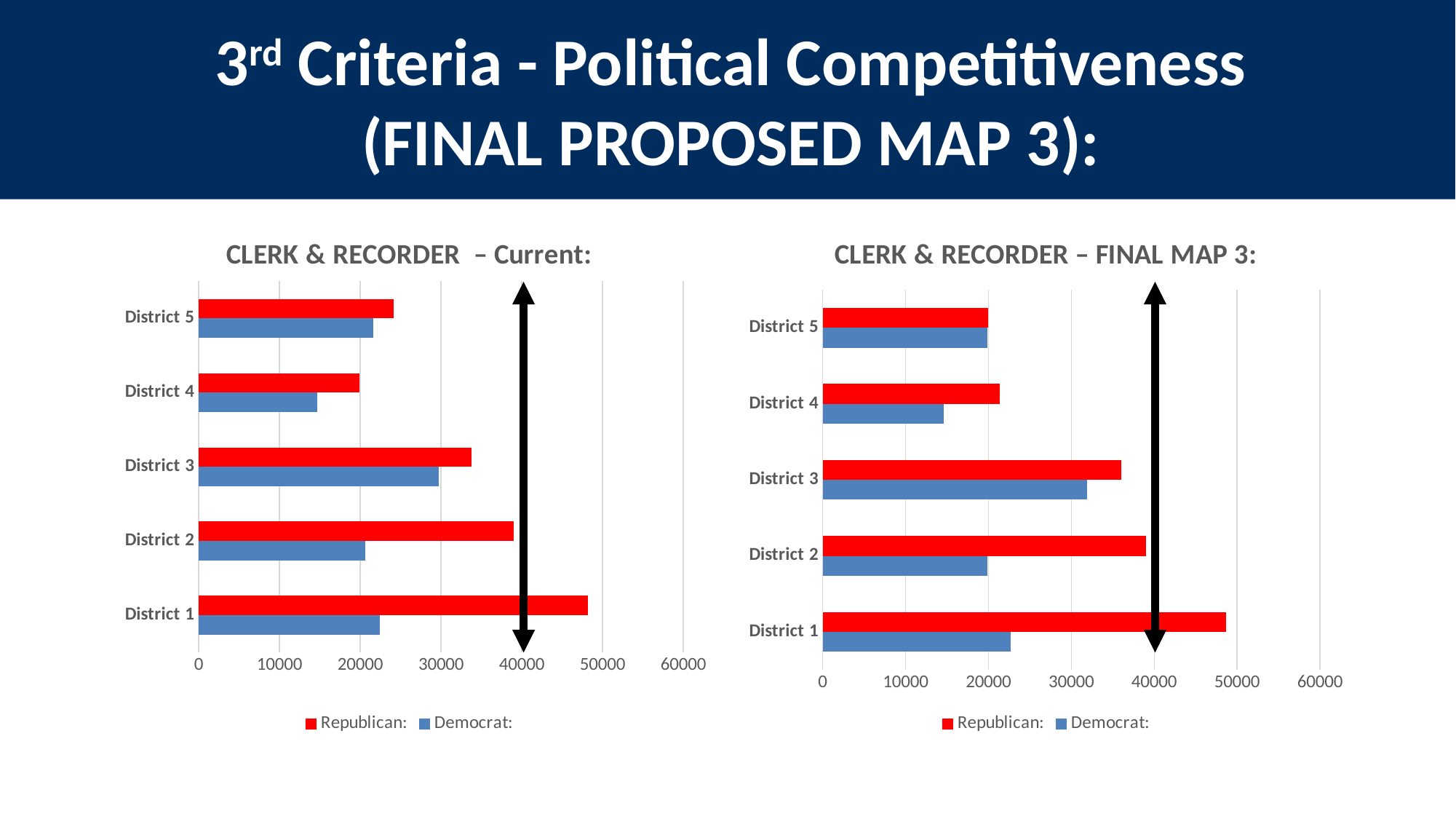
On the CLERK & RECORDER – Current chart, is the Democrat value for District 4 greater or less than 20000? less What kind of chart is the CLERK & RECORDER – Current chart? bar chart On the CLERK & RECORDER – Current chart, which district has the highest Republican value? District 1 How many districts are shown on the CLERK & RECORDER – FINAL MAP 3 chart? 5 On the CLERK & RECORDER – Current chart, is the Republican value for District 1 greater or less than 40000? greater How many series does the legend of the CLERK & RECORDER – Current chart list? 2 On the CLERK & RECORDER – FINAL MAP 3 chart, which is larger for District 2: the Republican value or the Democrat value? Republican On the CLERK & RECORDER – FINAL MAP 3 chart, is the Republican value for District 3 greater or less than 30000? greater On the CLERK & RECORDER – Current chart, which is larger: the Republican value for District 3 or the Republican value for District 5? District 3 What colour are the Democrat bars on the CLERK & RECORDER – FINAL MAP 3 chart? blue On the CLERK & RECORDER – FINAL MAP 3 chart, which district has the lowest Democrat value? District 4